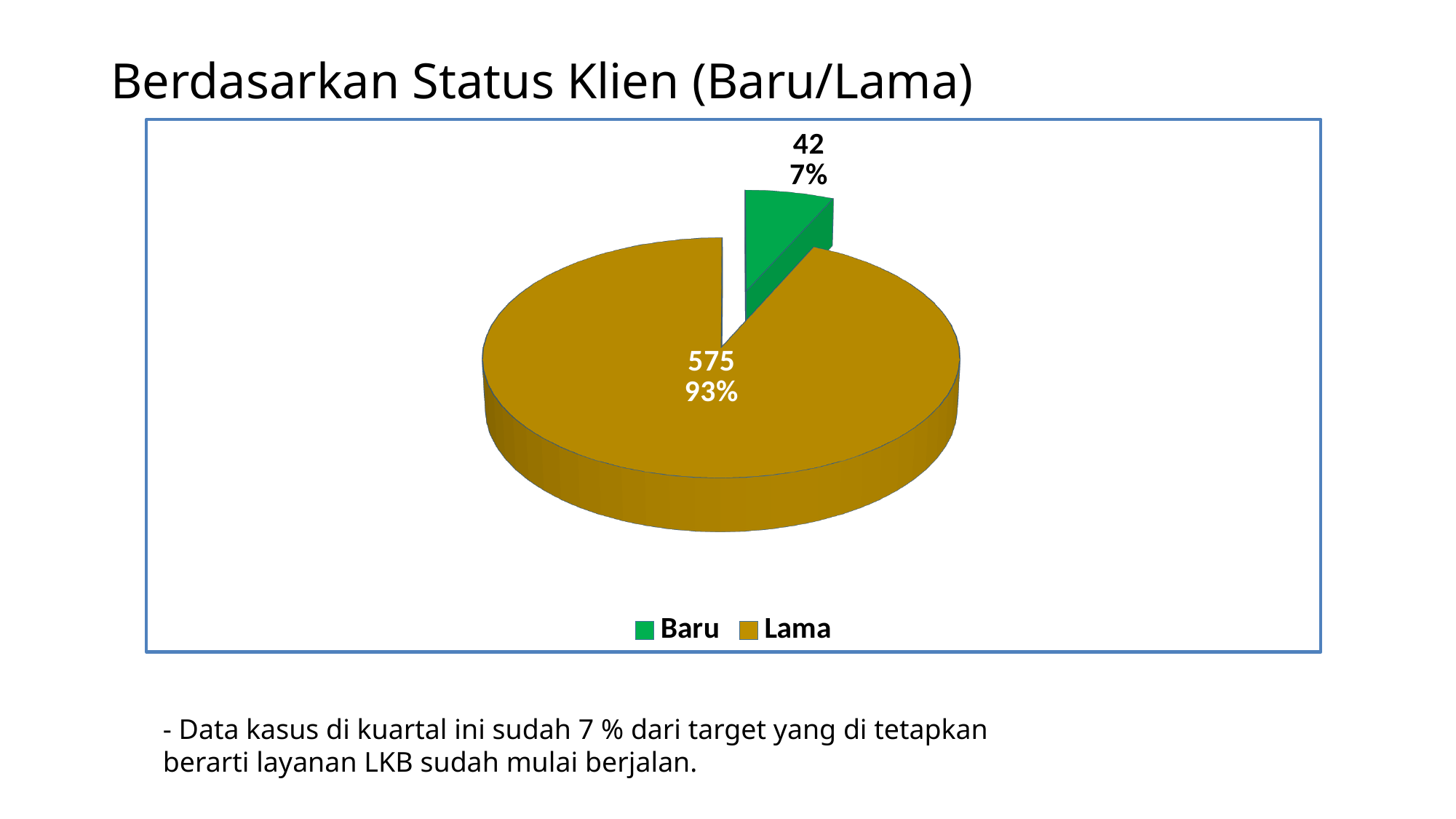
What is the value for Lama? 575 How many categories does the pie chart show? 2 Which is larger, the value for Baru or the value for Lama? Lama What percentage share does the Lama slice have? 93% Which category has the smallest slice? Baru What is the value for Baru? 42 What percentage share does the Baru slice have? 7% What is the total of the two slices in the pie chart? 617 What is the difference between the values for Lama and Baru? 533 What kind of chart is shown on the slide? Pie chart Which category has the largest slice? Lama What colour is the Baru slice? Green